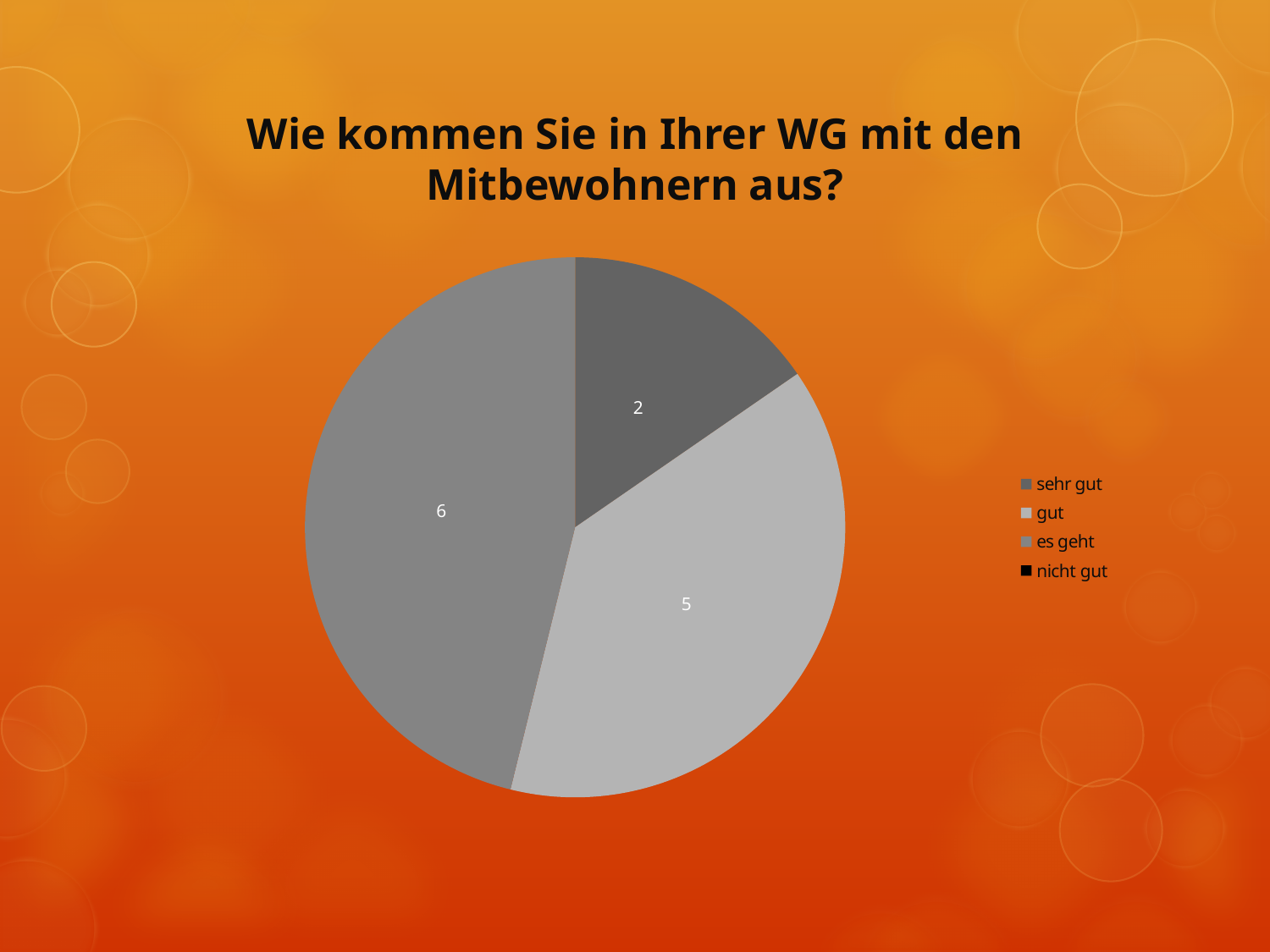
What is the difference between the values for "sehr gut" and "gut"? 3 What is the difference between the values for "sehr gut" and "es geht"? 4 What is the total of all the labelled slices in the pie? 13 What is the value for "sehr gut"? 2 Which is larger, the value for "gut" or the value for "es geht"? es geht What is the value for "gut"? 5 Which category with a visible slice has the smallest value? sehr gut What is the value for "es geht"? 6 What type of chart is shown on the slide? pie chart How many entries does the legend list? 4 What is the title of the chart? Wie kommen Sie in Ihrer WG mit den Mitbewohnern aus? Which category has the largest slice of the pie? es geht